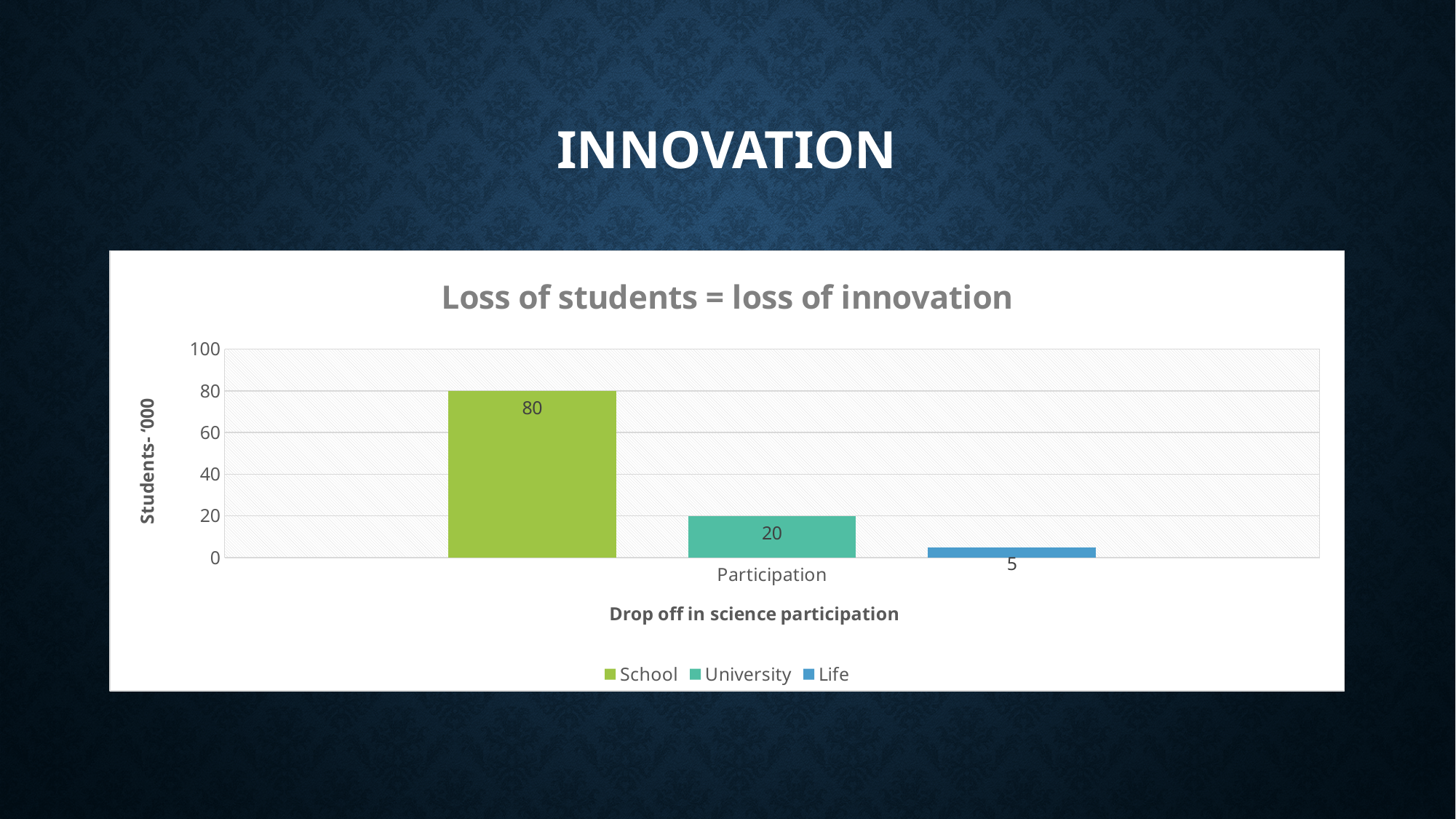
What is the value for Life? 5 How many series does the legend list? 3 Which series has the highest value? School What is the difference between the School and University values? 60 What kind of chart is shown? Bar chart Which series has the lowest value? Life What is the value for University? 20 Which is larger, the value for University or the value for Life? University What is the title of the chart? Loss of students = loss of innovation What is the difference between the University and Life values? 15 What is the label of the vertical axis? Students- '000 What is the value for School? 80